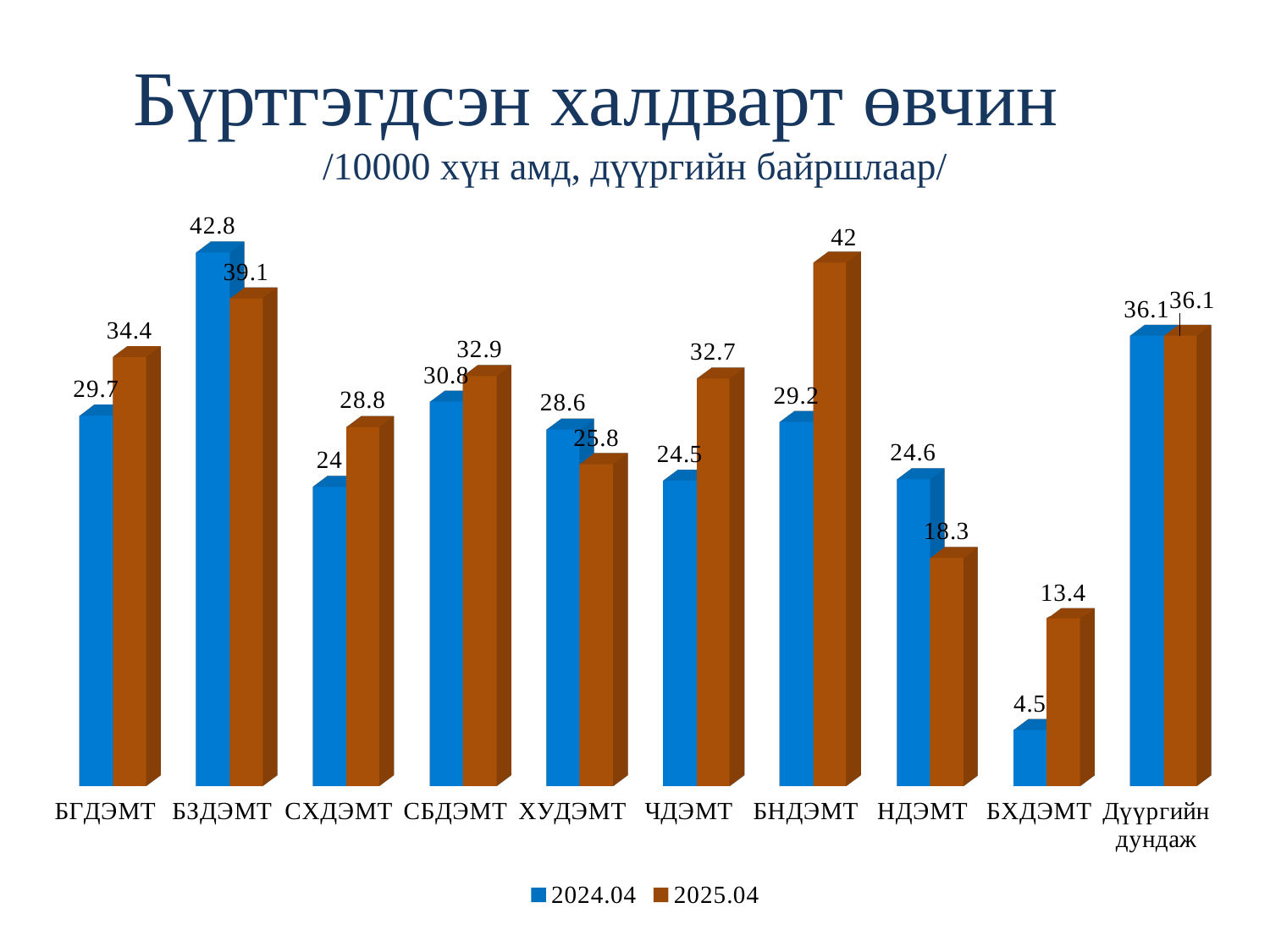
How many categories are shown on the x axis? 10 What is the value for БЗДЭМТ in the 2024.04 series? 42.8 What is the difference between the 2025.04 and 2024.04 values for БНДЭМТ? 12.8 Which category has the highest value in the 2025.04 series? БНДЭМТ What kind of chart is shown on the slide? Bar chart How many series does the legend list? 2 Which is larger for ХУДЭМТ: the 2024.04 value or the 2025.04 value? 2024.04 What is the value for Дүүргийн дундаж in the 2025.04 series? 36.1 What is the value for НДЭМТ in the 2025.04 series? 18.3 Which category has the lowest value in the 2024.04 series? БХДЭМТ What is the value for БНДЭМТ in the 2025.04 series? 42 What is the value for БХДЭМТ in the 2024.04 series? 4.5